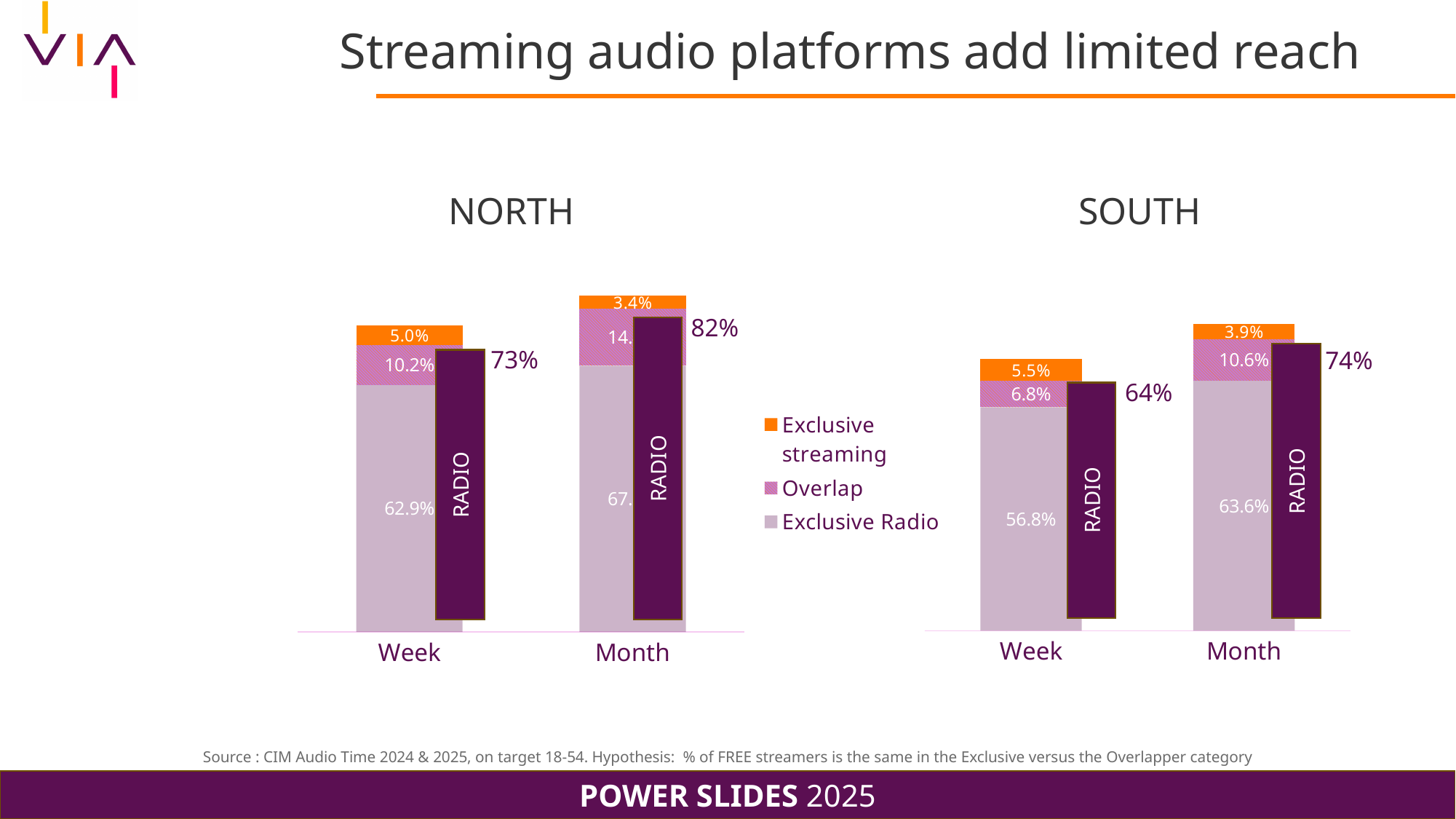
In the SOUTH chart, what is the Exclusive Radio value for Week? 56.8% In the SOUTH chart, what is the difference between the Exclusive Radio values for Month and Week? 6.8% How many series does the legend list for the charts? 3 In the NORTH chart, what is the difference between the Exclusive streaming values for Week and Month? 1.6% Which is larger: the Exclusive streaming value for Week in the NORTH chart or in the SOUTH chart? SOUTH In the SOUTH chart, what is the Overlap value for Month? 10.6% In the NORTH chart, what is the Overlap value for Week? 10.2% In the NORTH chart, what percentage is shown next to the RADIO bar for Month? 82% In the SOUTH chart, what is the total of the stacked bar for Week? 69.1% In the SOUTH chart, what percentage is shown next to the RADIO bar for Week? 64% In the NORTH chart, what is the Exclusive streaming value for Week? 5.0% What kind of chart is the NORTH chart? Stacked bar chart